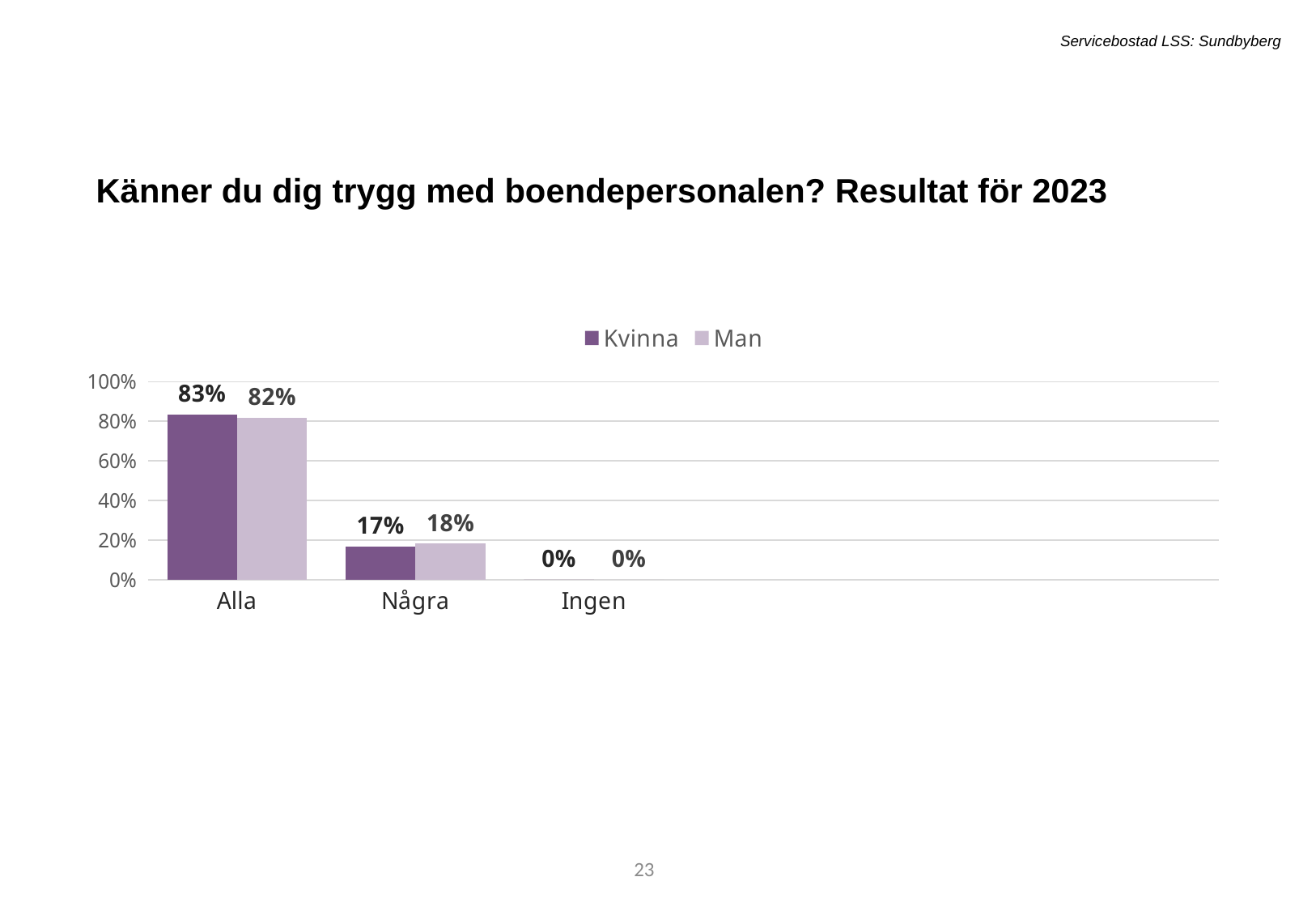
What is the value for Kvinna in the Alla category? 83% Which category has the lowest value for Man? Ingen What is the value for Man in the Några category? 18% How many categories are shown on the x axis? 3 Which is larger in the Några category, Kvinna or Man? Man What is the value for Man in the Alla category? 82% What is the value for Kvinna in the Ingen category? 0% What kind of chart is shown on the slide? Bar chart What is the difference between the Kvinna and Man values in the Alla category? 1% Which category has the highest value for Kvinna? Alla How many series does the legend list? 2 What is the value for Kvinna in the Några category? 17%